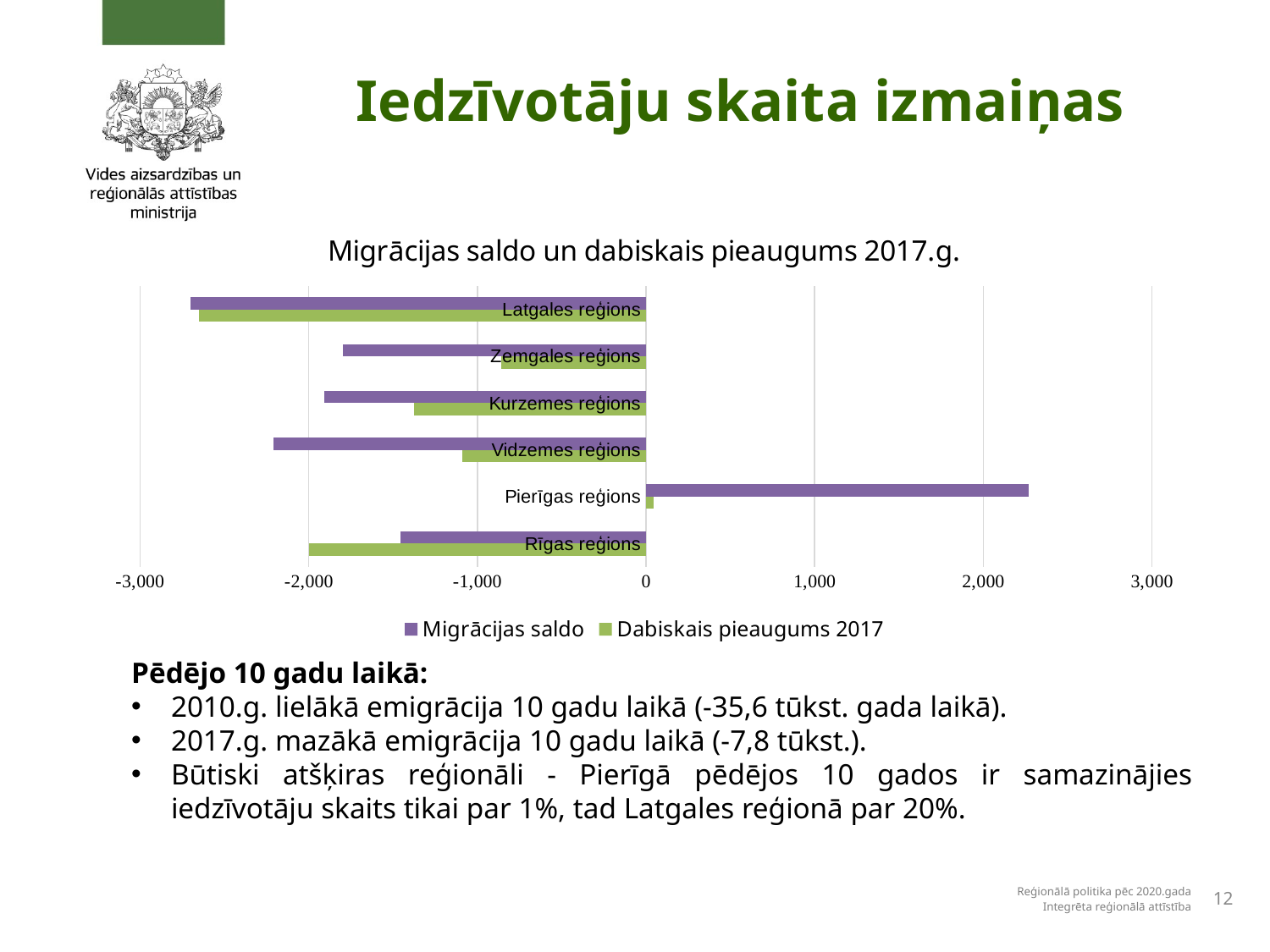
Which is larger for Rīgas reģions: the Migrācijas saldo value or the Dabiskais pieaugums 2017 value? Migrācijas saldo What is the title of the chart? Migrācijas saldo un dabiskais pieaugums 2017.g. Which region has the lowest Migrācijas saldo value? Latgales reģions How many series does the legend list? 2 What kind of chart is shown on the slide? bar chart Which region has the lowest Dabiskais pieaugums 2017 value? Latgales reģions Which colour represents the Migrācijas saldo series? purple Is the Migrācijas saldo value for Vidzemes reģions greater or less than -2,000? less Which is larger for Kurzemes reģions: the Migrācijas saldo value or the Dabiskais pieaugums 2017 value? Dabiskais pieaugums 2017 Which region has the highest Migrācijas saldo value? Pierīgas reģions How many regions are shown on the chart? 6 Is the Migrācijas saldo value for Pierīgas reģions greater or less than 2,000? greater